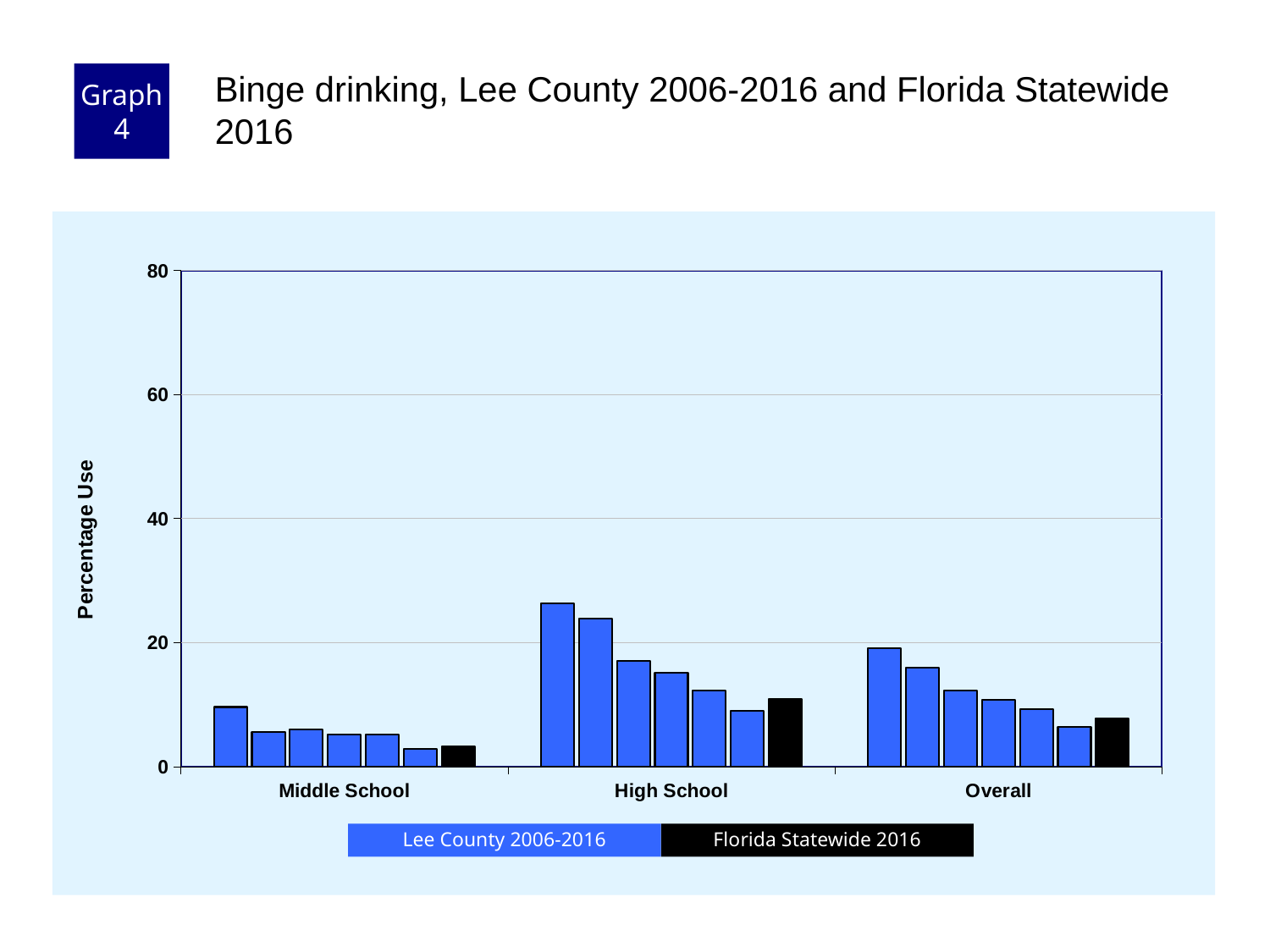
Is the Florida Statewide 2016 bar for Middle School greater or less than 20? less Within the High School group, do the Lee County 2006-2016 bars rise or fall from left to right? fall Which category has the lowest bars overall? Middle School Is the tallest Lee County bar for Overall greater or less than 40? less Which category has the tallest bar? High School How many categories are shown along the x axis? 3 What is the label on the y axis? Percentage Use Which series is shown in black? Florida Statewide 2016 What kind of chart is shown on the slide? bar chart Which is larger: the Florida Statewide 2016 bar for High School or the Florida Statewide 2016 bar for Middle School? High School Is the tallest Lee County bar for High School greater or less than 20? greater How many series does the legend list? 2